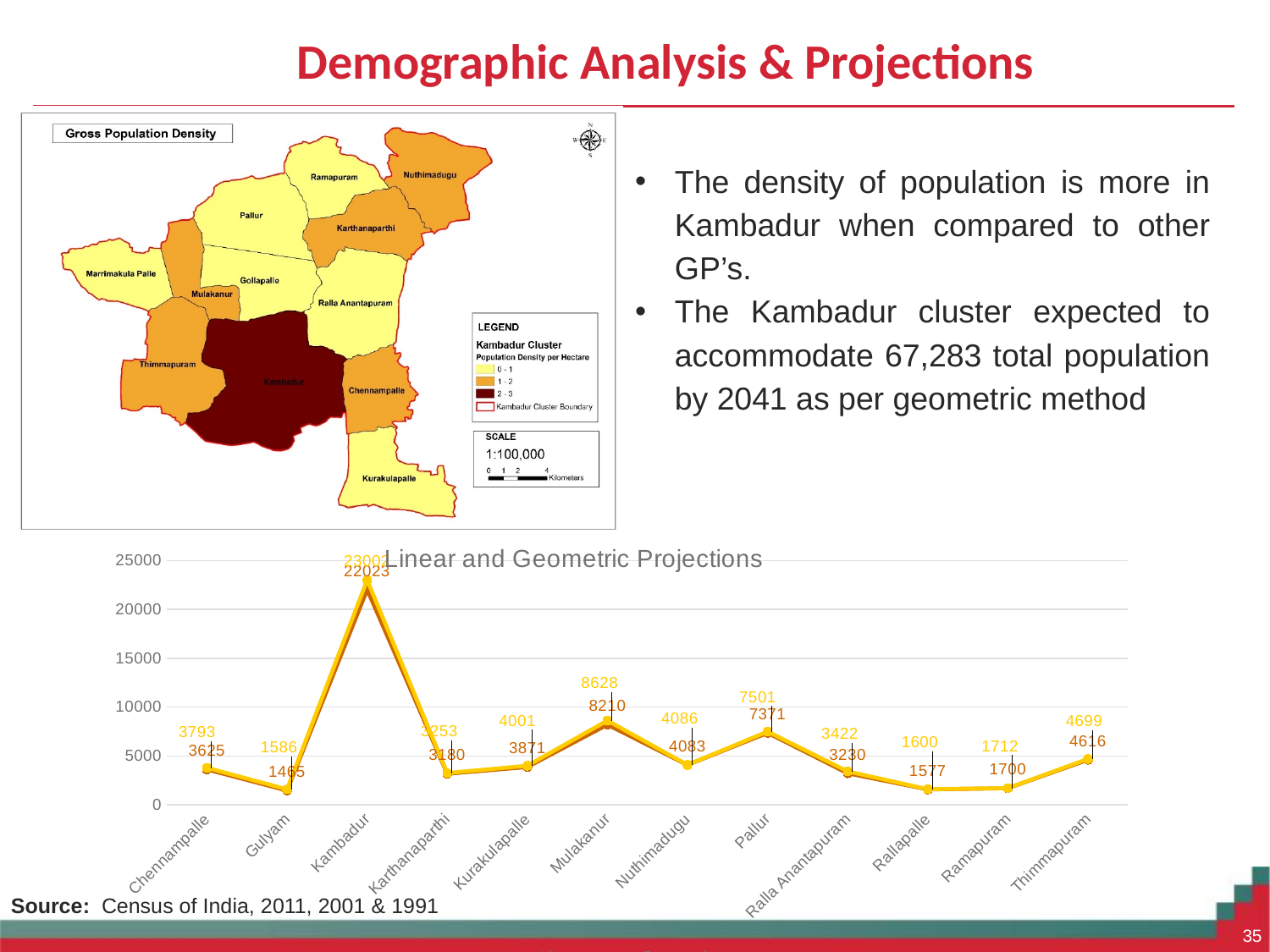
What kind of chart is the "Linear and Geometric Projections" chart? line chart In the "Linear and Geometric Projections" chart, which has higher values, Pallur or Nuthimadugu? Pallur What is the title of the line chart at the bottom of the slide? Linear and Geometric Projections In the "Linear and Geometric Projections" chart, what is the lower data label shown for Pallur? 7371 In the "Linear and Geometric Projections" chart, which category has the highest values? Kambadur In the "Linear and Geometric Projections" chart, which category has the lowest value among the lower data labels? Gulyam In the "Linear and Geometric Projections" chart, are the values for Kambadur greater or less than 20000? greater In the "Linear and Geometric Projections" chart, what is the difference between the two data labels for Mulakanur (8628 and 8210)? 418 In the "Linear and Geometric Projections" chart, what is the lower data label shown for Ramapuram? 1700 How many categories are shown on the x axis of the "Linear and Geometric Projections" chart? 12 In the "Linear and Geometric Projections" chart, what is the higher data label shown for Mulakanur? 8628 In the "Linear and Geometric Projections" chart, are the values for Thimmapuram greater or less than 5000? less